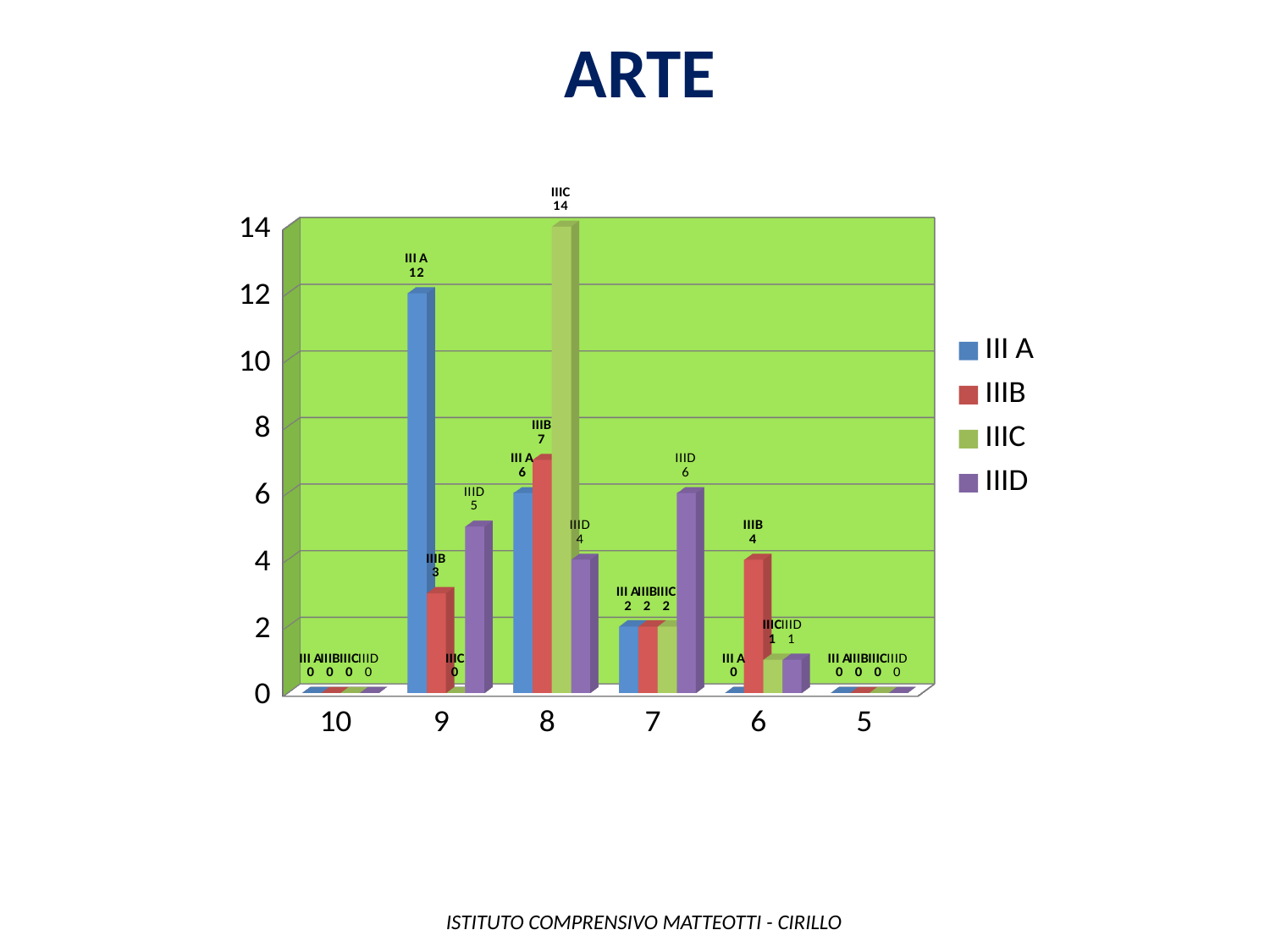
How many series does the legend list? 4 What is the value for IIIB at grade 6? 4 What is the value for IIIC at grade 8? 14 What is the difference between the III A value at grade 9 and the IIIB value at grade 9? 9 What kind of chart is shown on the slide? Bar chart Which series has the highest value at grade 8? IIIC What is the title of the chart? ARTE What is the value for IIID at grade 7? 6 What is the value for III A at grade 9? 12 How many grade categories are shown on the x axis? 6 Which series has the lowest value at grade 9? IIIC Which is larger at grade 8: the value for IIIB or the value for IIID? IIIB